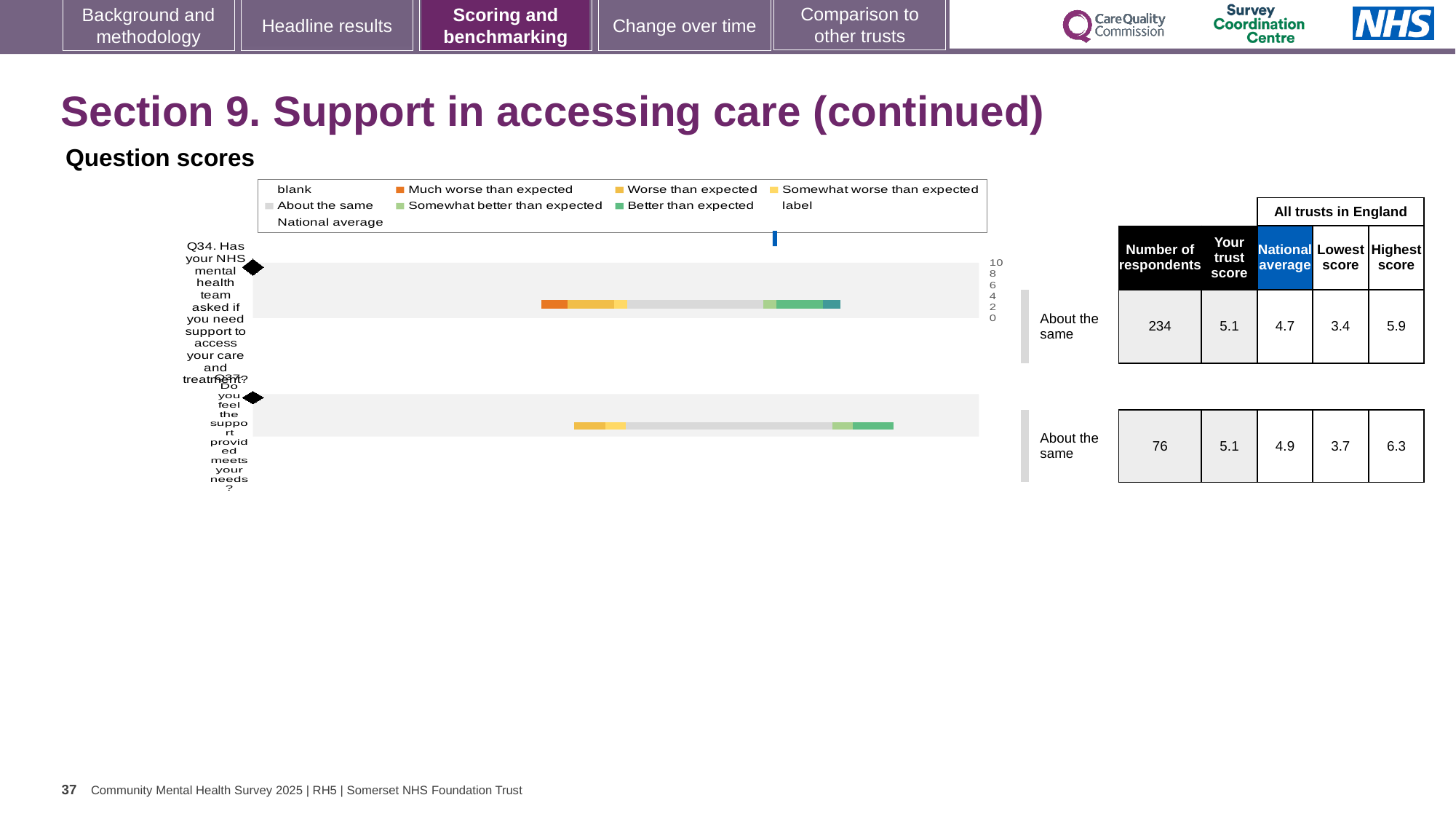
What is the difference between the highest score and the lowest score for Q34? 2.5 Which question has the higher national average, Q34 or Q37? Q37 What benchmark category is shown for Q37? About the same In the legend, which category is shown in orange? Much worse than expected What kind of chart is used to show the question scores on this slide? bar chart How many questions (bars) are plotted in the question scores chart? 2 Which question has more respondents, Q34 or Q37? Q34 How many respondents answered Q34? 234 What is the 'Your trust score' for Q34 (Has your NHS mental health team asked if you need support to access your care and treatment)? 5.1 What is the national average score for Q37 (Do you feel the support provided meets your needs)? 4.9 What is the lowest score across all trusts in England for Q34? 3.4 What is the highest score across all trusts in England for Q37? 6.3